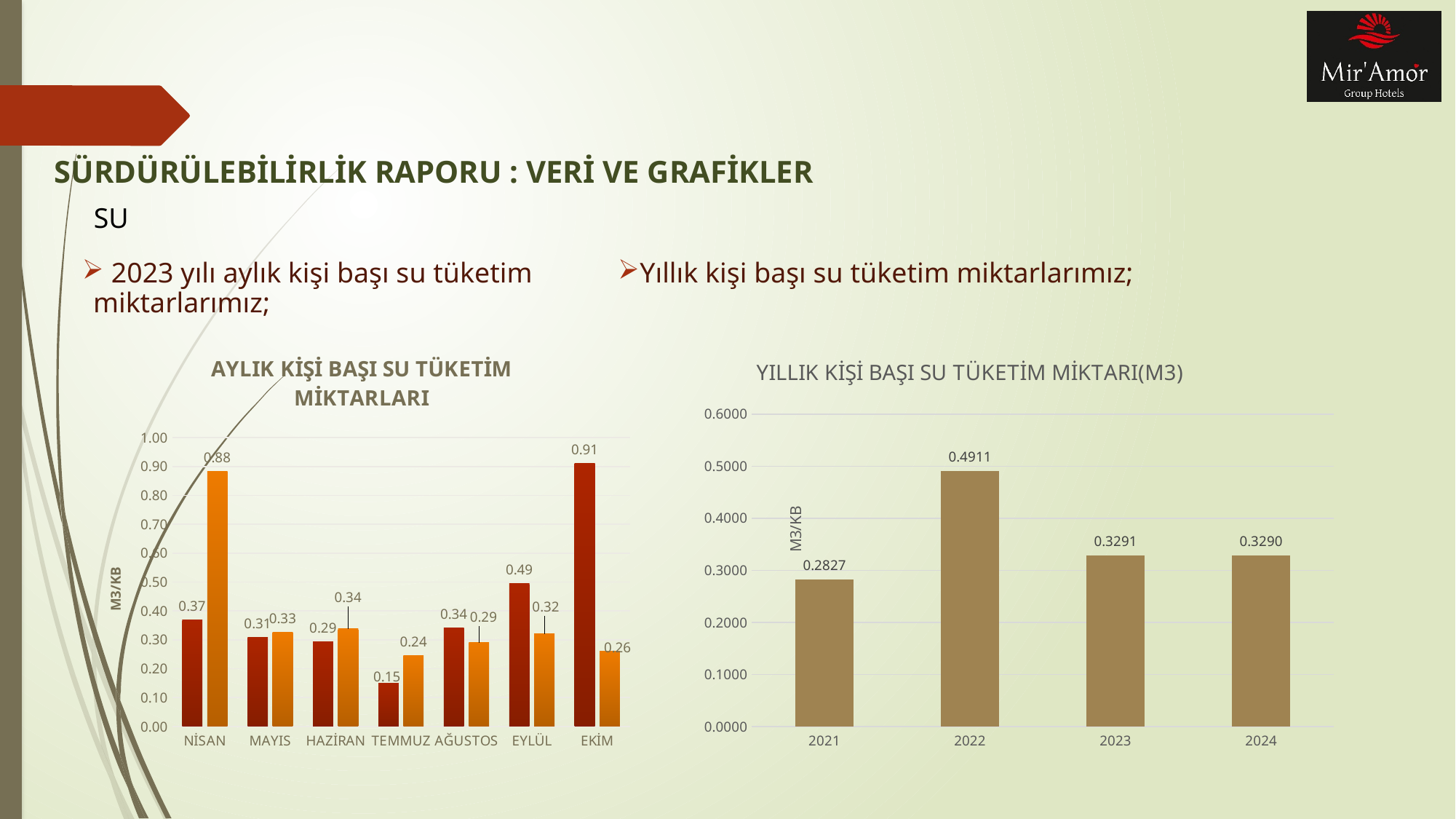
In the chart titled 'YILLIK KİŞİ BAŞI SU TÜKETİM MİKTARI(M3)', how many years are shown on the x axis? 4 In the chart titled 'YILLIK KİŞİ BAŞI SU TÜKETİM MİKTARI(M3)', what is the difference between the 2022 and 2021 values? 0.2084 In the chart titled 'YILLIK KİŞİ BAŞI SU TÜKETİM MİKTARI(M3)', which year has the lowest value? 2021 In the chart titled 'AYLIK KİŞİ BAŞI SU TÜKETİM MİKTARLARI', what is the value of the orange bar for NİSAN? 0.88 In the chart titled 'YILLIK KİŞİ BAŞI SU TÜKETİM MİKTARI(M3)', what is the value for 2022? 0.4911 In the chart titled 'YILLIK KİŞİ BAŞI SU TÜKETİM MİKTARI(M3)', which year has the highest value? 2022 In the chart titled 'YILLIK KİŞİ BAŞI SU TÜKETİM MİKTARI(M3)', what is the value for 2021? 0.2827 In the chart titled 'AYLIK KİŞİ BAŞI SU TÜKETİM MİKTARLARI', which month has the lowest dark red bar? TEMMUZ In the chart titled 'AYLIK KİŞİ BAŞI SU TÜKETİM MİKTARLARI', which is larger for EYLÜL: the dark red bar or the orange bar? the dark red bar In the chart titled 'AYLIK KİŞİ BAŞI SU TÜKETİM MİKTARLARI', what is the value of the dark red bar for EKİM? 0.91 What kind of chart is the chart titled 'AYLIK KİŞİ BAŞI SU TÜKETİM MİKTARLARI'? bar chart In the chart titled 'AYLIK KİŞİ BAŞI SU TÜKETİM MİKTARLARI', how many months are shown on the x axis? 7